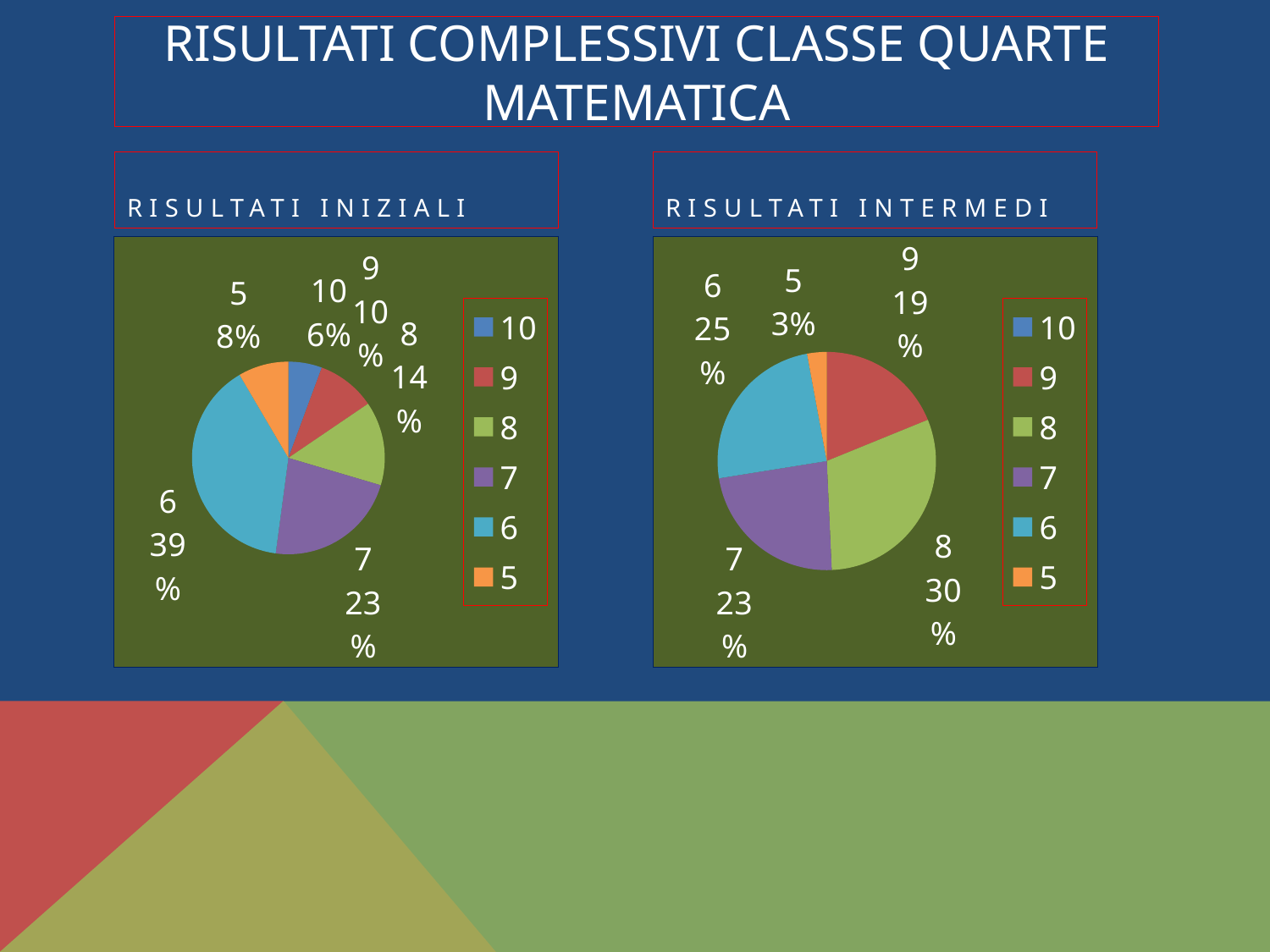
In the RISULTATI INTERMEDI chart, which labelled grade has the smallest slice? 5 In the RISULTATI INTERMEDI chart, what share of the pie does grade 6 have? 25% In the RISULTATI INTERMEDI chart, what is the value for grade 8? 30% In the RISULTATI INTERMEDI chart, which is larger, the slice for grade 9 or the slice for grade 7? 7 What type of chart is the RISULTATI INTERMEDI chart? Pie chart In the RISULTATI INTERMEDI chart, what is the difference between the shares for grade 8 and grade 5? 27% In the RISULTATI INIZIALI chart, which grade has the smallest slice? 10 How many entries does the legend of the RISULTATI INIZIALI chart list? 6 In the RISULTATI INIZIALI chart, what is the value for grade 8? 14% In the RISULTATI INIZIALI chart, what share of the pie does grade 6 have? 39% In the RISULTATI INIZIALI chart, which grade has the largest slice? 6 In the RISULTATI INIZIALI chart, what is the difference between the shares for grade 7 and grade 9? 13%